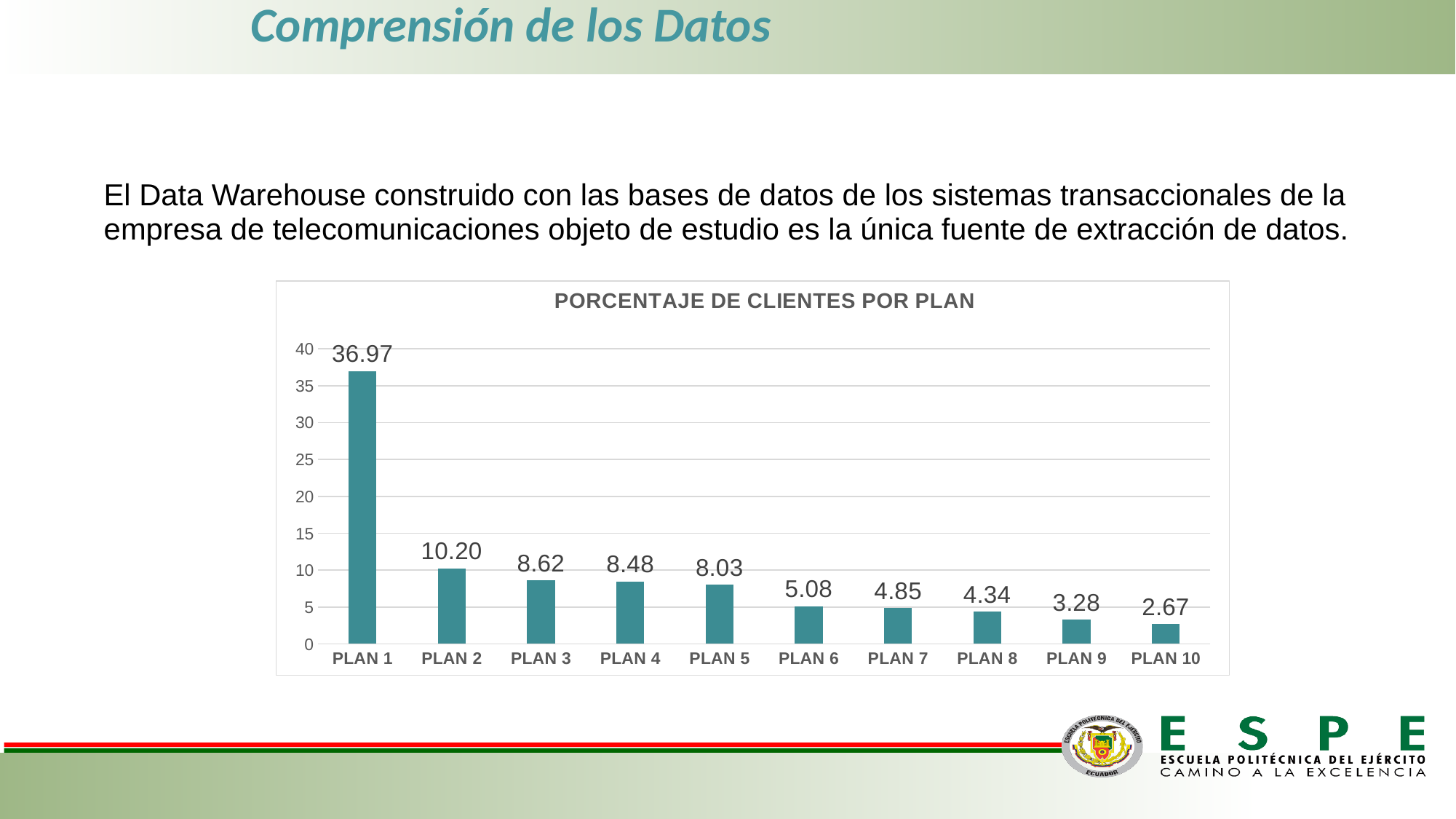
Which plan has the lowest percentage of clients? PLAN 10 Which plan has the highest percentage of clients? PLAN 1 What is the difference between the values for PLAN 6 and PLAN 9? 1.80 How many plans are shown on the x axis? 10 Which is larger, the value for PLAN 3 or the value for PLAN 7? PLAN 3 What is the title of the chart? PORCENTAJE DE CLIENTES POR PLAN What is the value for PLAN 10? 2.67 What is the difference between the values for PLAN 1 and PLAN 2? 26.77 What kind of chart is shown on the slide? bar chart What is the value for PLAN 5? 8.03 Is the value for PLAN 2 greater or less than 5? greater What is the value for PLAN 1? 36.97